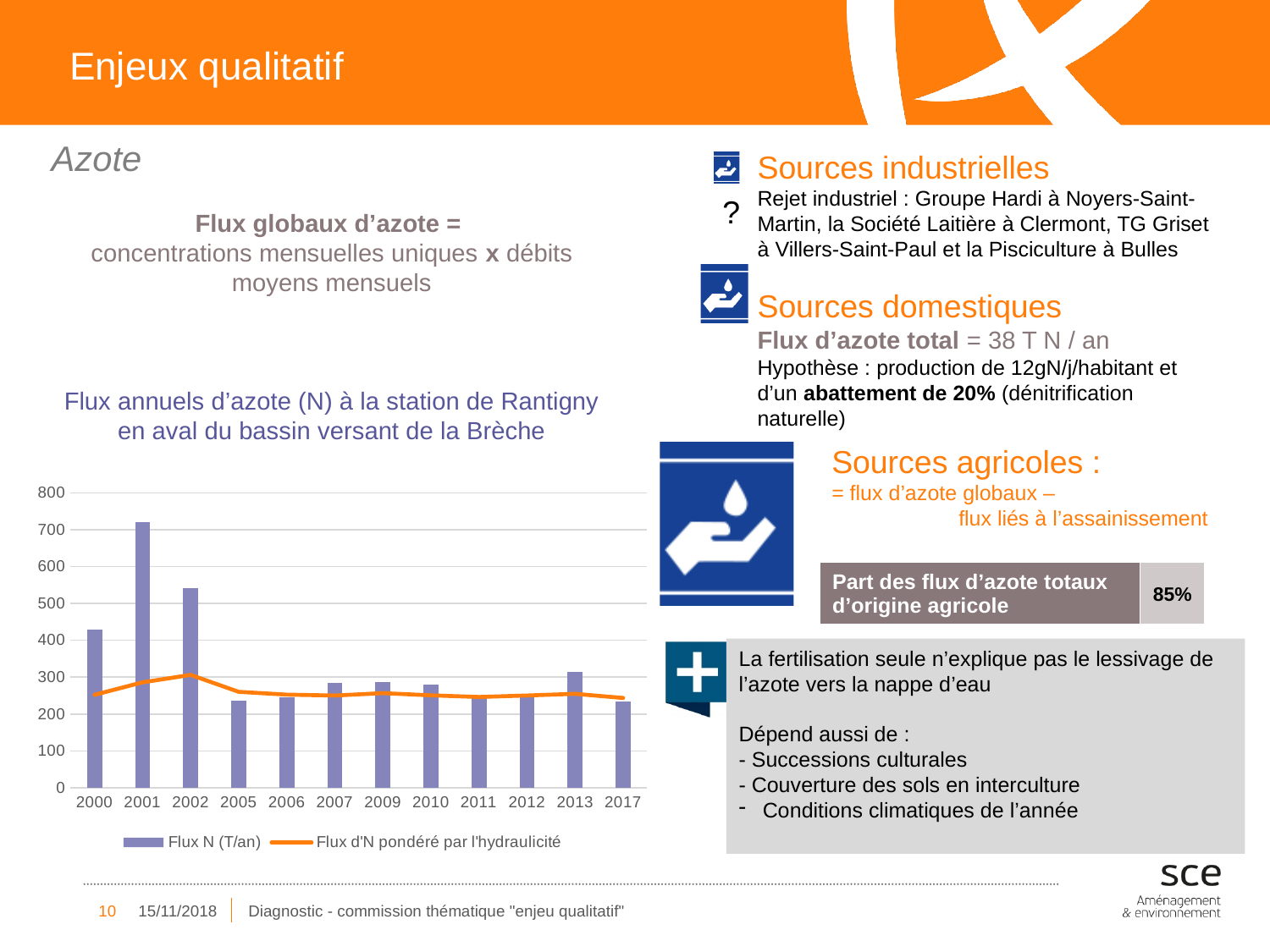
Is the Flux N (T/an) value for 2000 greater or less than 400? greater Which year has the highest Flux N (T/an) bar? 2001 What kind of chart is shown on the slide? Bar chart with a line overlay What is the title of the chart? Flux annuels d'azote (N) à la station de Rantigny en aval du bassin versant de la Brèche Is the Flux N (T/an) value for 2005 greater or less than 300? less Is the Flux N (T/an) value for 2001 greater or less than 700? greater Which series in the chart is drawn as an orange line? Flux d'N pondéré par l'hydraulicité Which year has the larger Flux N (T/an) bar, 2000 or 2002? 2002 Do the Flux N (T/an) bars rise or fall from 2001 to 2005? fall How many years are shown on the x axis of the chart? 12 How many series does the chart legend list? 2